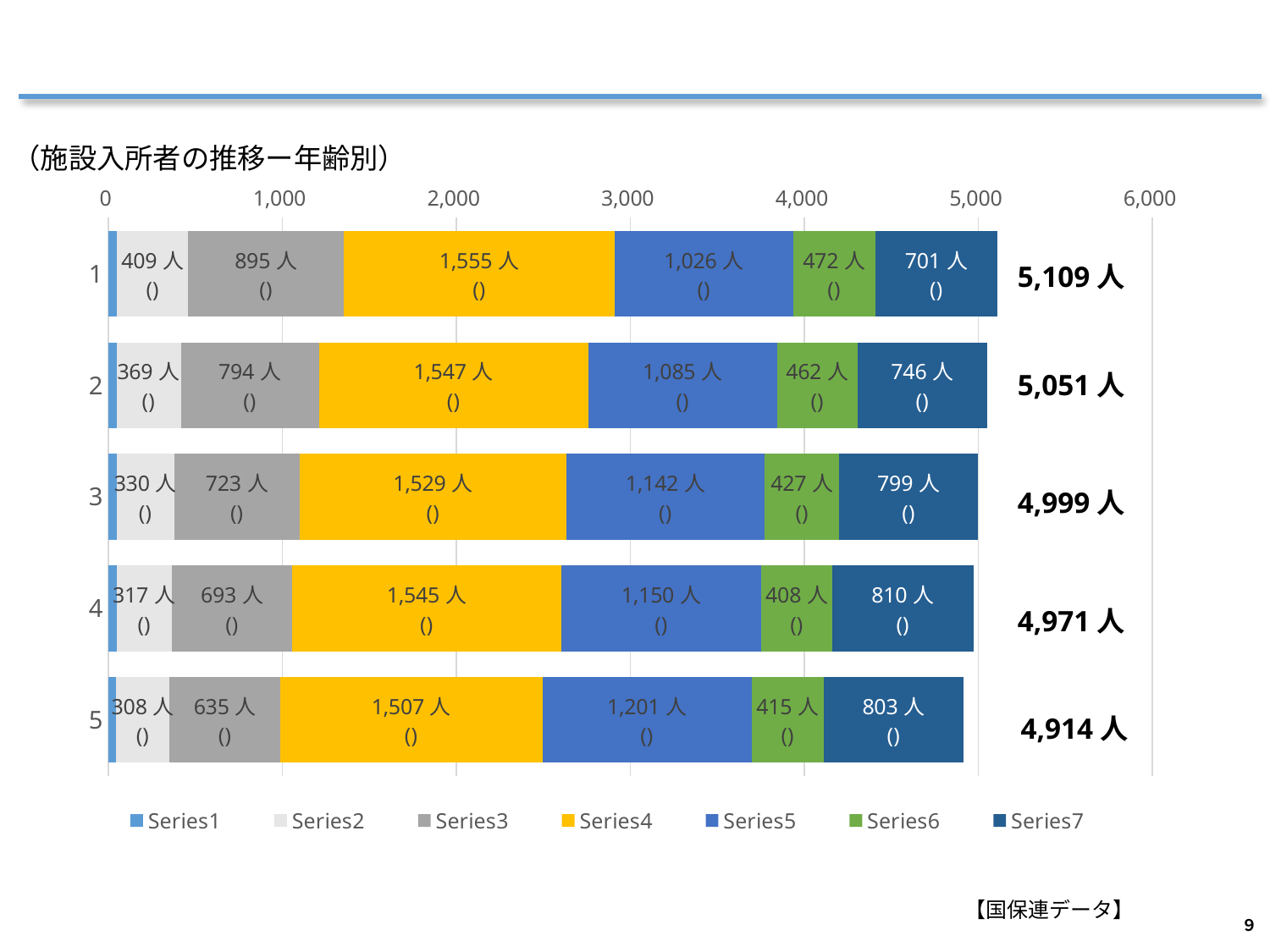
Which is larger, the Series3 value for category 1 or for category 2? Category 1 What is the value of Series2 for category 4? 317 人 What kind of chart is shown on the slide? Stacked bar chart Do the bar totals rise or fall from category 1 to category 5? Fall How many series does the legend list? 7 Which category has the lowest total? 5 What is the difference between the Series5 value for category 5 and the Series5 value for category 1? 175 人 Which category has the highest total? 1 What is the value of Series7 for category 5? 803 人 What is the total shown for the stacked bar of category 3? 4,999 人 What is the value of Series4 for category 1? 1,555 人 How many categories are plotted on the chart? 5